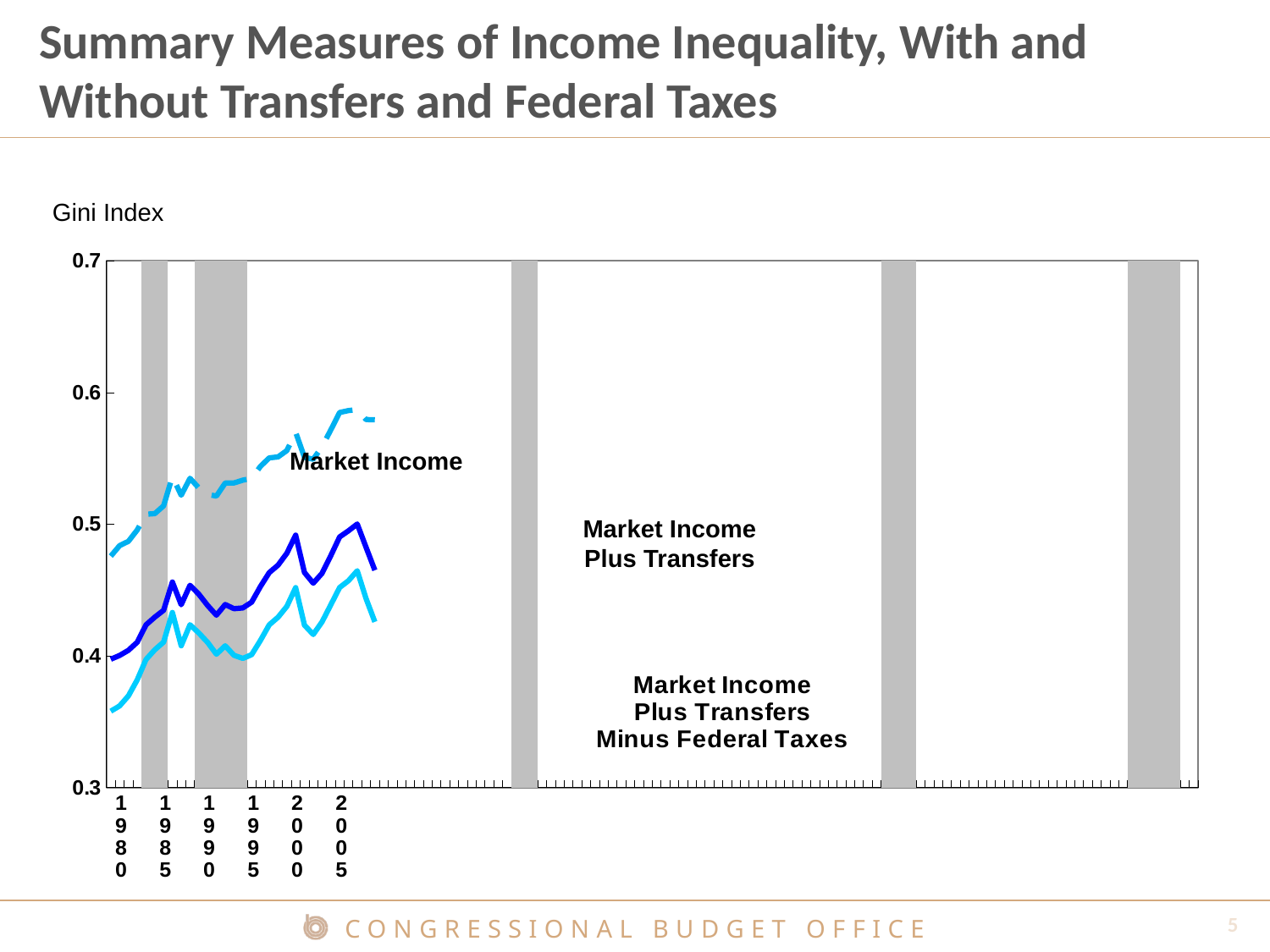
What kind of chart is shown on the slide? line chart Is the Gini Index for Market Income in 1980 greater or less than 0.5? less Is the Gini Index for Market Income around 2005 greater or less than 0.5? greater What is the label of the y axis? Gini Index Which series has the lowest Gini Index values throughout the period shown? Market Income Plus Transfers Minus Federal Taxes Which is larger in 1995: the Gini Index for Market Income or for Market Income Plus Transfers? Market Income Which series has the highest Gini Index values throughout the period shown? Market Income Does the Gini Index for Market Income generally rise or fall from 1980 to 2005? rise How many data series are plotted on the chart? 3 How many year labels are shown on the x axis? 6 Is the highest value reached by the Market Income Plus Transfers Minus Federal Taxes series greater or less than 0.5? less